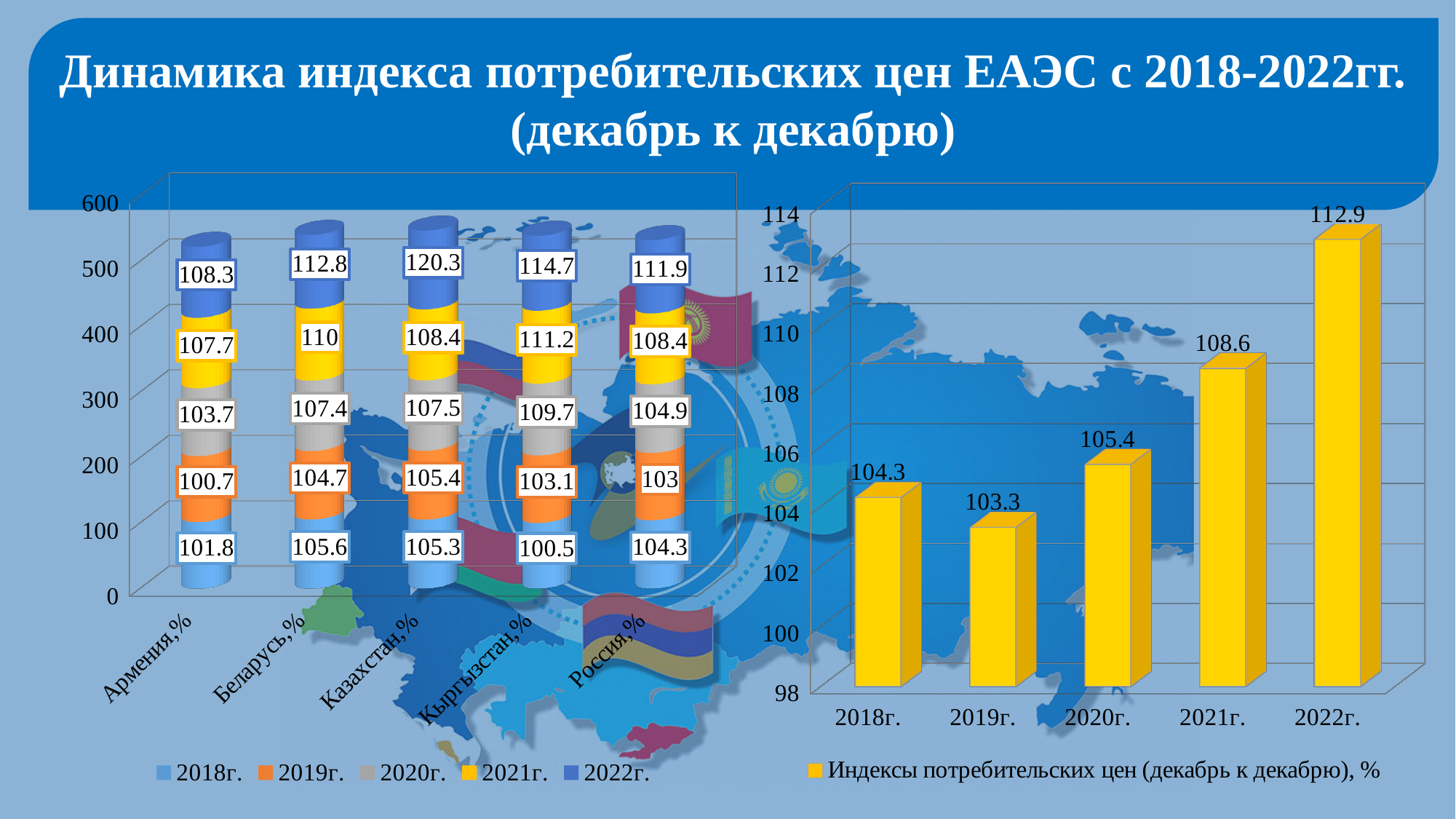
In the left chart, what is the 2018г. value for Кыргызстан,%? 100.5 In the right chart, do the values rise or fall from 2019г. to 2022г.? rise In the left chart, which is larger: the 2021г. value for Беларусь,% or the 2021г. value for Армения,%? Беларусь,% What kind of chart is the left chart? stacked bar chart In the left chart, which country has the highest 2022г. value? Казахстан,% In the left chart, what is the 2022г. value for Казахстан,%? 120.3 In the right chart, which year has the highest value? 2022г. In the right chart, how many years are shown on the x axis? 5 In the left chart, how many series does the legend list? 5 In the right chart, which year has the lowest value? 2019г. In the right chart, what is the consumer price index value for 2022г.? 112.9 In the right chart, what is the difference between the values for 2021г. and 2020г.? 3.2